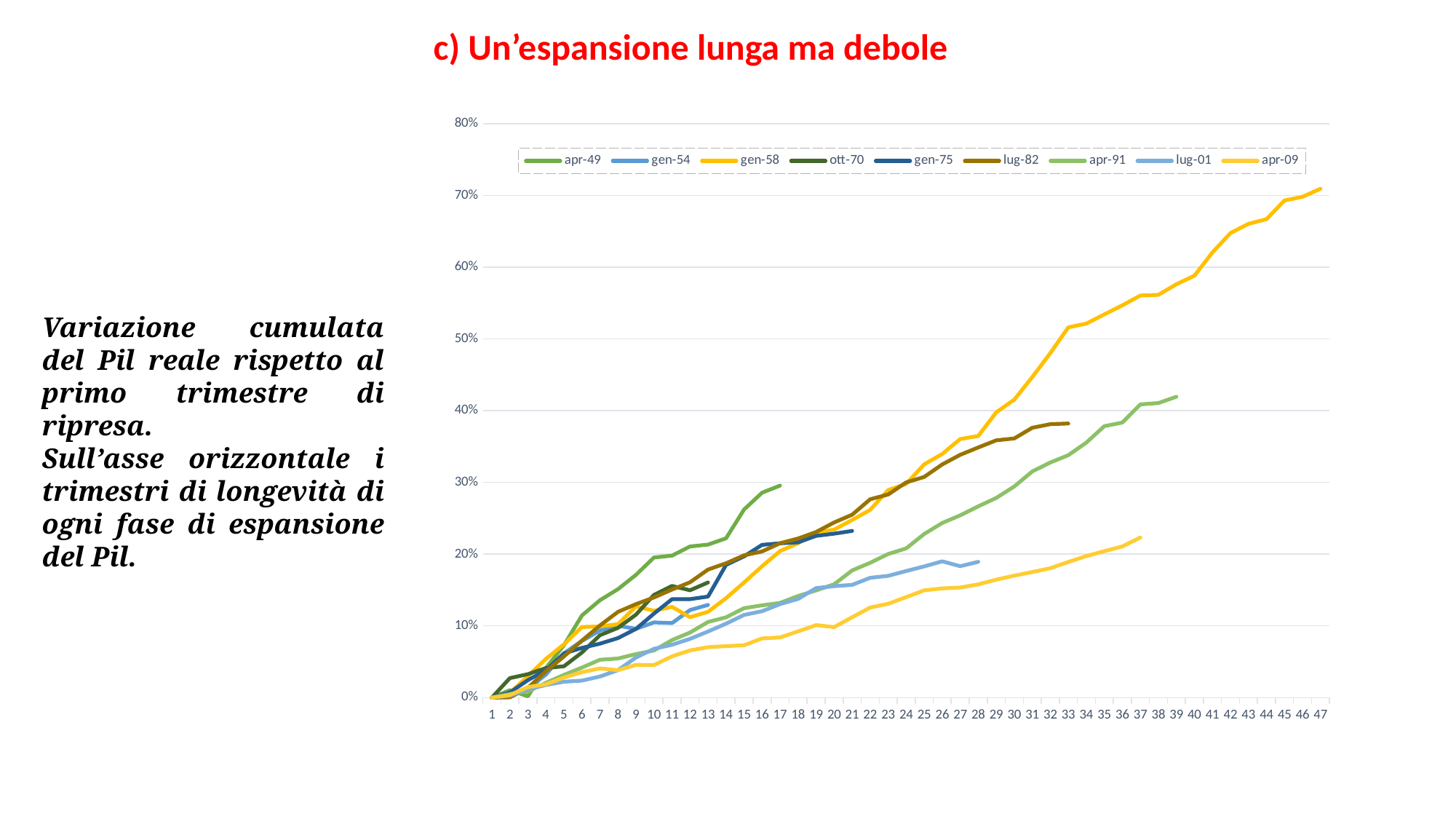
What is the last quarter number shown on the horizontal axis? 47 What is the first entry in the chart legend? apr-49 What is the highest value shown on the vertical axis? 80% What kind of chart is shown on the slide? line chart Is the highest point of the line that extends to quarter 47 greater or less than 60%? greater Is the final value of the apr-49 line greater or less than 20%? greater How many series does the legend list? 9 Do the lines generally rise or fall as the quarter number increases? rise What is the title of the slide above the chart? c) Un'espansione lunga ma debole Which line reaches a higher final value, apr-49 or gen-75? apr-49